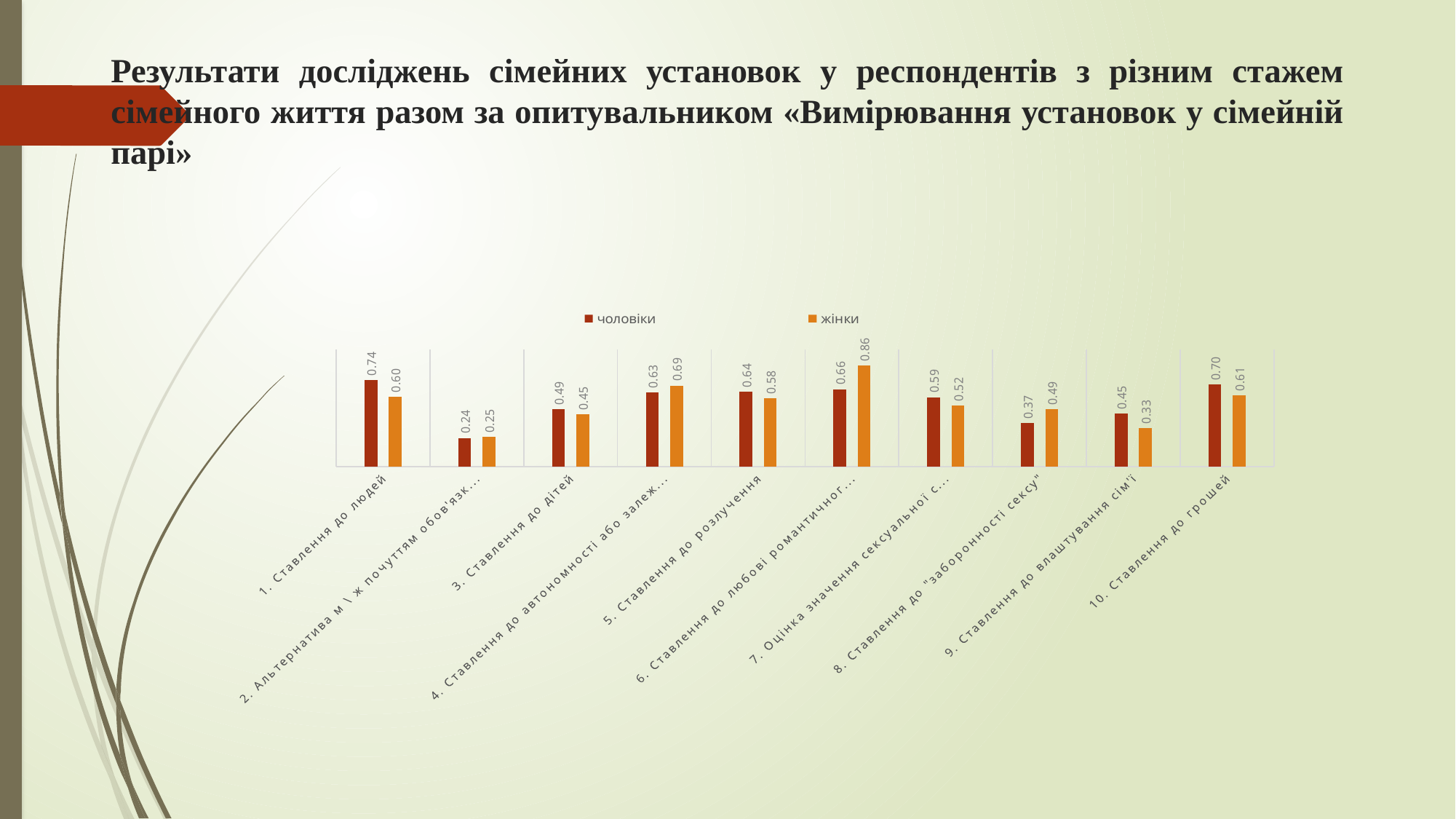
How many categories are shown on the x axis of the chart? 10 What type of chart is shown on the slide? Bar chart What is the value for чоловіки in the category "1. Ставлення до людей"? 0.74 In the category "10. Ставлення до грошей", which series has the larger value, чоловіки or жінки? чоловіки Which category has the lowest value for чоловіки? 2. Альтернатива м \ ж почуттям обов'язк... What is the value for жінки in the category "5. Ставлення до розлучення"? 0.58 In the category "8. Ставлення до "заборонності сексу"", which series has the larger value, чоловіки or жінки? жінки Which category has the highest value for жінки? 6. Ставлення до любові романтичног... How many series does the chart legend list? 2 What is the value for чоловіки in the category "9. Ставлення до влаштування сім'ї"? 0.45 What is the difference between the чоловіки and жінки values in the category "1. Ставлення до людей"? 0.14 What is the value for жінки in the category "10. Ставлення до грошей"? 0.61